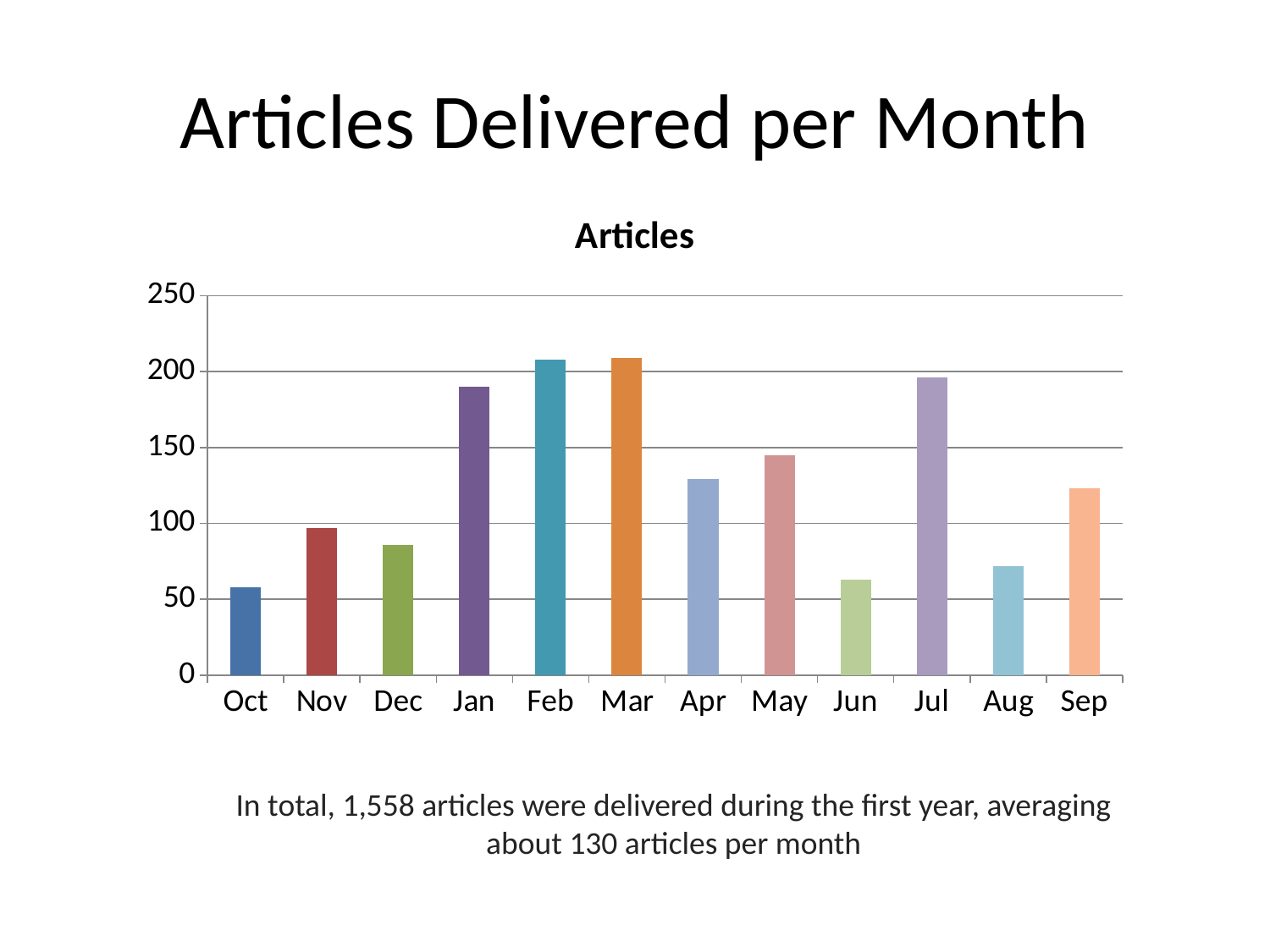
What is the title shown above the chart's plot area? Articles What kind of chart is shown on the slide? bar chart Is the value for Dec greater or less than 100? less Which month has the larger value, Jul or Aug? Jul Which month has the larger value, Jan or Apr? Jan Is the value for Apr greater or less than 150? less Is the value for Jan greater or less than 200? less Which month has the larger value, Jun or Sep? Sep How many months are shown on the x axis of the chart? 12